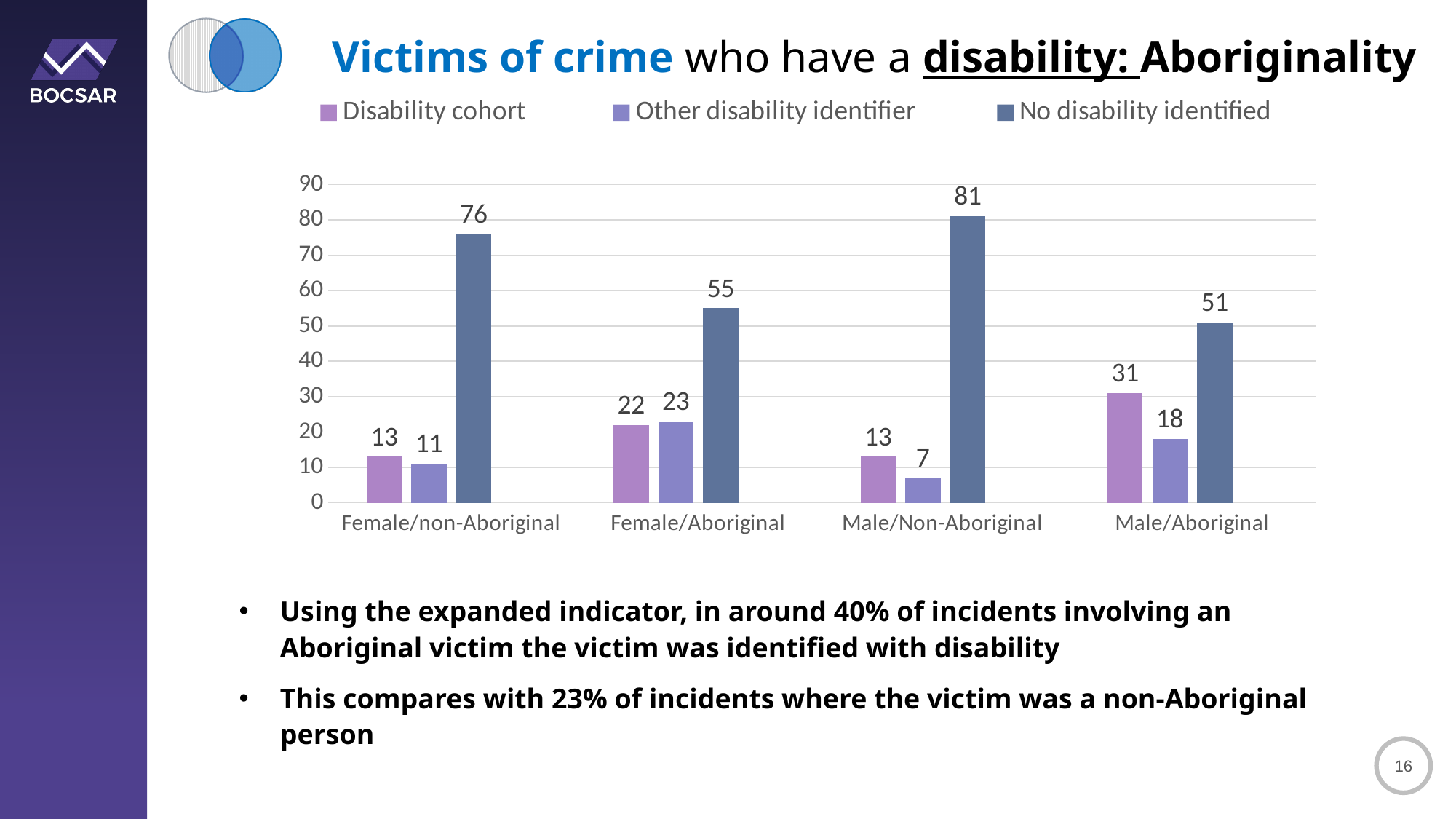
Is the 'No disability identified' value for Female/Aboriginal greater or less than 50? greater What is the difference between the 'No disability identified' values for Male/Non-Aboriginal and Male/Aboriginal? 30 What is the value for 'No disability identified' in the Female/non-Aboriginal category? 76 How many series does the legend list? 3 Which category has the highest value for 'No disability identified'? Male/Non-Aboriginal What is the value for 'Disability cohort' in the Male/Aboriginal category? 31 What kind of chart is shown on the slide? Bar chart How many categories are shown on the x axis? 4 Which legend entry is shown in the darkest colour? No disability identified What is the value for 'Other disability identifier' in the Male/Non-Aboriginal category? 7 Which category has the lowest value for 'Other disability identifier'? Male/Non-Aboriginal Which is larger: the 'Disability cohort' value for Female/Aboriginal or for Male/Aboriginal? Male/Aboriginal